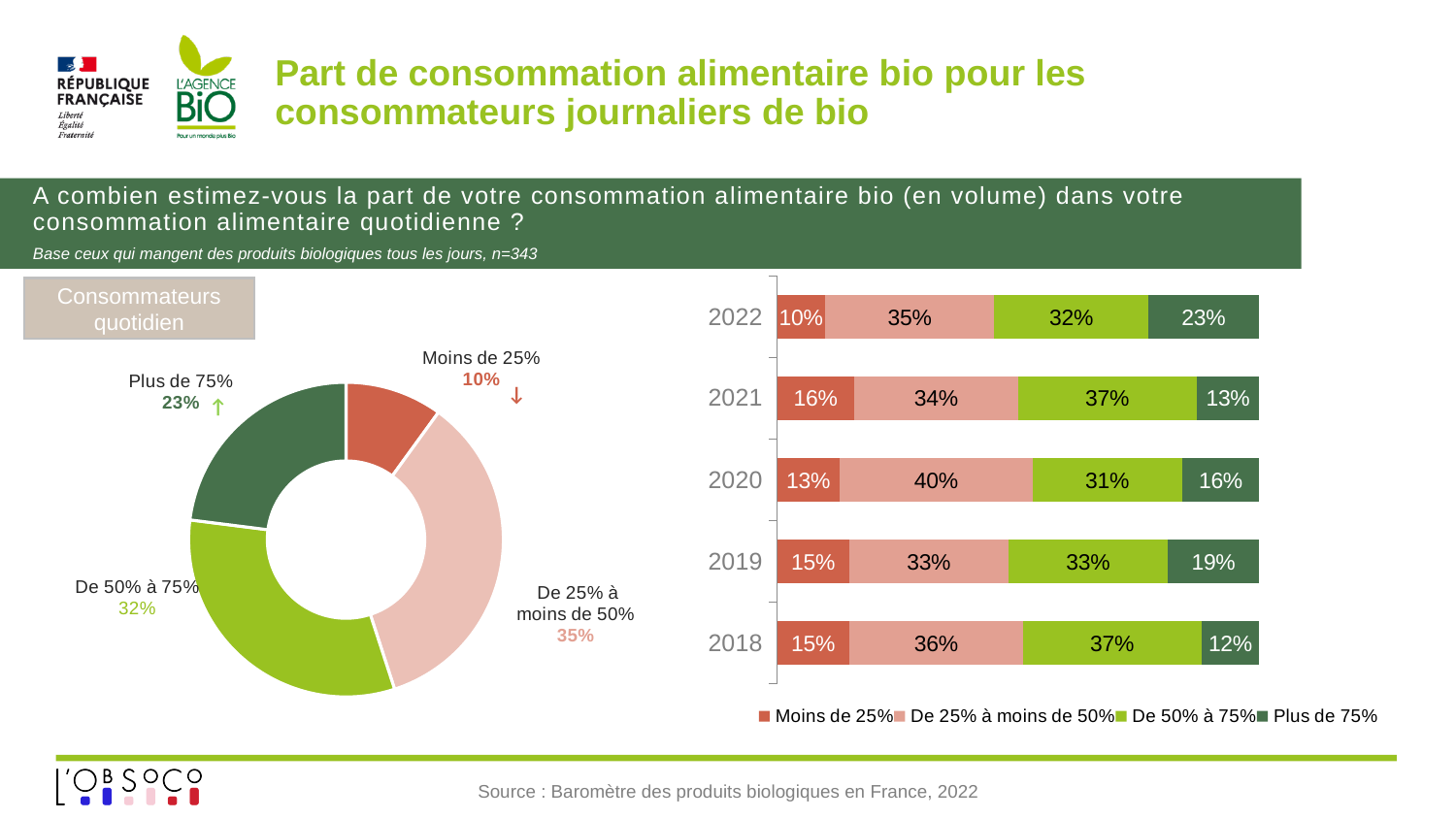
How many years are shown in the stacked bar chart on the right? 5 In the stacked bar chart on the right, what is the value for "Moins de 25%" in 2021? 16% In the stacked bar chart on the right, is the "Moins de 25%" value larger in 2019 or in 2022? 2019 In the stacked bar chart on the right, what is the difference between the "De 50% à 75%" values for 2021 and 2022? 5 percentage points In the donut chart on the left, which category has the largest share? De 25% à moins de 50% In the stacked bar chart on the right, what is the value for "De 25% à moins de 50%" in 2020? 40% How many series does the legend of the stacked bar chart on the right list? 4 In the stacked bar chart on the right, in which year is the "Plus de 75%" value highest? 2022 What type of chart is shown on the right side of the slide? Stacked bar chart In the donut chart on the left, which category has the smallest share? Moins de 25% In the donut chart on the left, what share is shown for "Plus de 75%"? 23% In the stacked bar chart on the right, what is the value for "Plus de 75%" in 2018? 12%